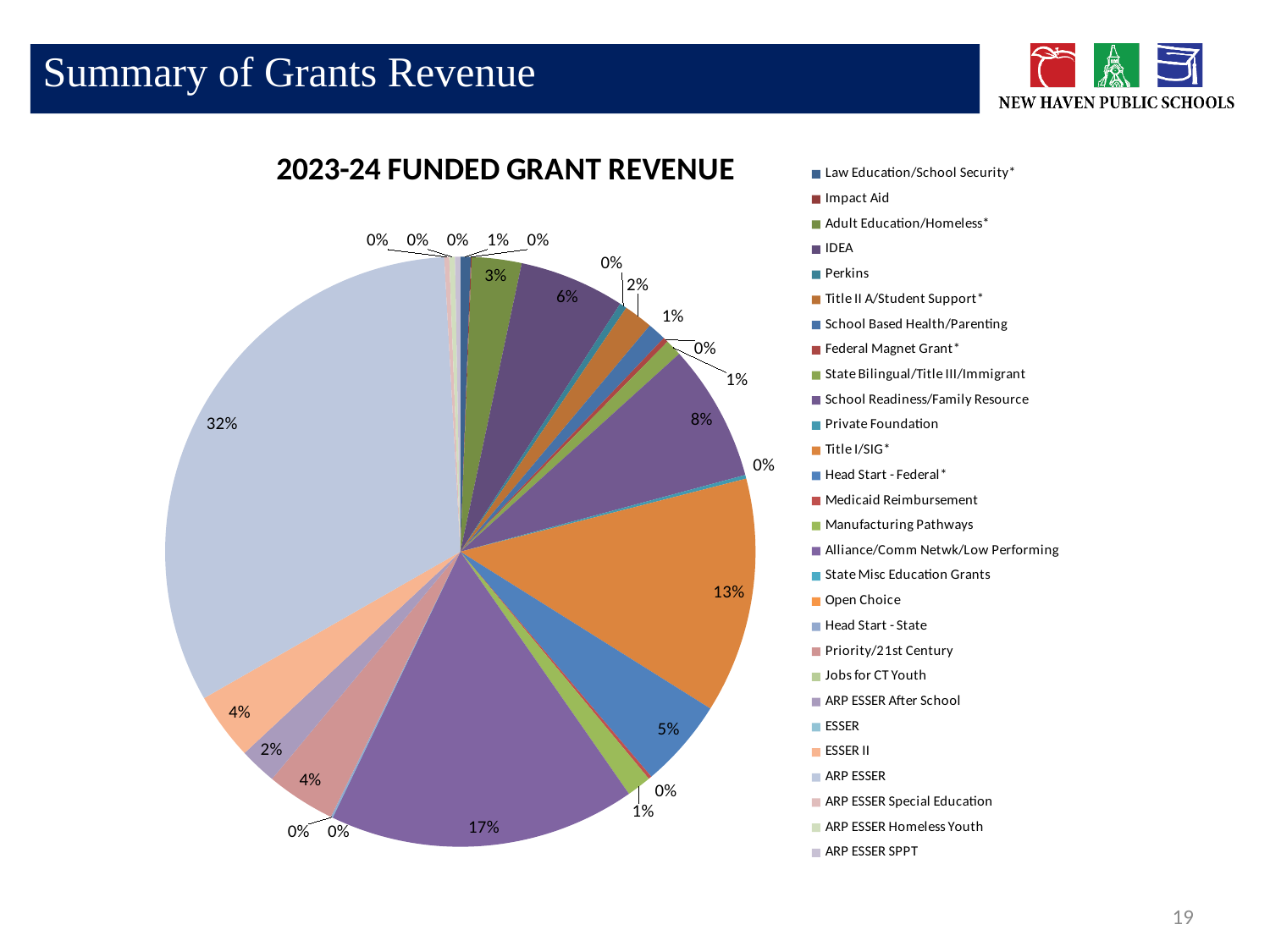
What type of chart is shown on the slide? Pie chart What share of funded grant revenue is labeled for ARP ESSER? 32% Which grant has the largest share of the 2023-24 funded grant revenue? ARP ESSER What is the difference in percentage points between the 32% slice and the 17% slice? 15 percentage points What is the title of the chart? 2023-24 FUNDED GRANT REVENUE What share of funded grant revenue is labeled for Alliance/Comm Netwk/Low Performing? 17% What share of funded grant revenue is labeled for Title I/SIG*? 13% Which is larger: the share for Title I/SIG* or the share for Alliance/Comm Netwk/Low Performing? Alliance/Comm Netwk/Low Performing How many entries does the chart's legend list? 28 What is the second-largest share labeled on the pie chart? 17% What share of funded grant revenue is labeled for School Readiness/Family Resource? 8% What is the largest share shown on the pie chart? 32%